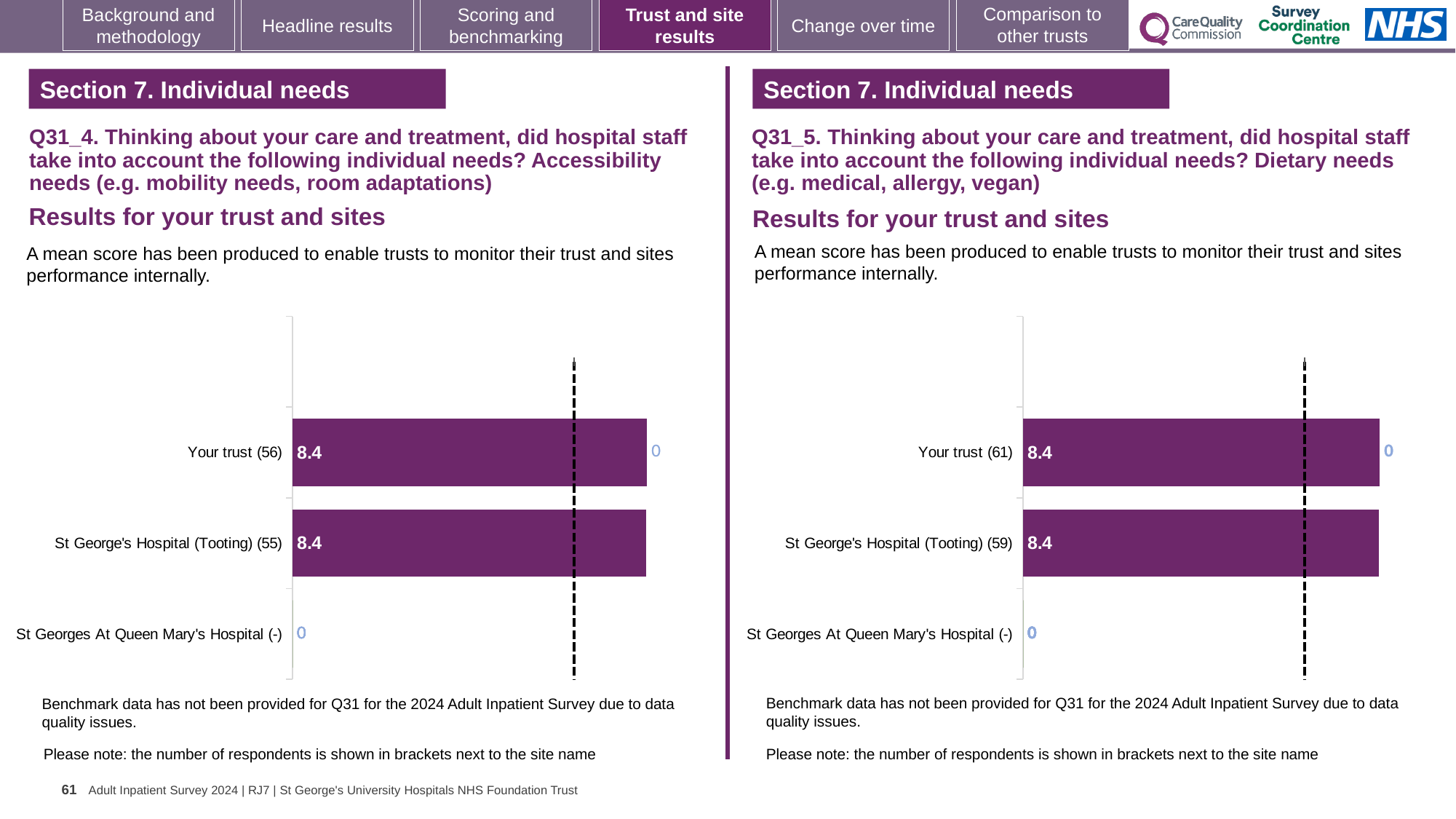
In the Q31_4 chart on the left, how many respondents are shown in brackets for Your trust? 56 In the Q31_5 chart on the right, what is the difference between the scores for Your trust and St George's Hospital (Tooting)? 0 In the Q31_4 chart on the left, what is the mean score for Your trust? 8.4 In the Q31_5 chart on the right, is the score for Your trust the same as the score for St George's Hospital (Tooting)? Yes, both are 8.4 In the Q31_5 chart on the right, what is the mean score for Your trust? 8.4 In the Q31_4 chart on the left, what is the mean score for St George's Hospital (Tooting)? 8.4 How many categories are shown in the Q31_5 chart on the right? 3 What kind of chart is used for the Q31_4 results on the left? Bar chart In the Q31_5 chart on the right, how many respondents are shown in brackets for St George's Hospital (Tooting)? 59 In the Q31_4 chart on the left, what value is shown for St Georges At Queen Mary's Hospital? 0 How many categories are shown in the Q31_4 chart on the left? 3 In the Q31_5 chart on the right, what is the mean score for St George's Hospital (Tooting)? 8.4